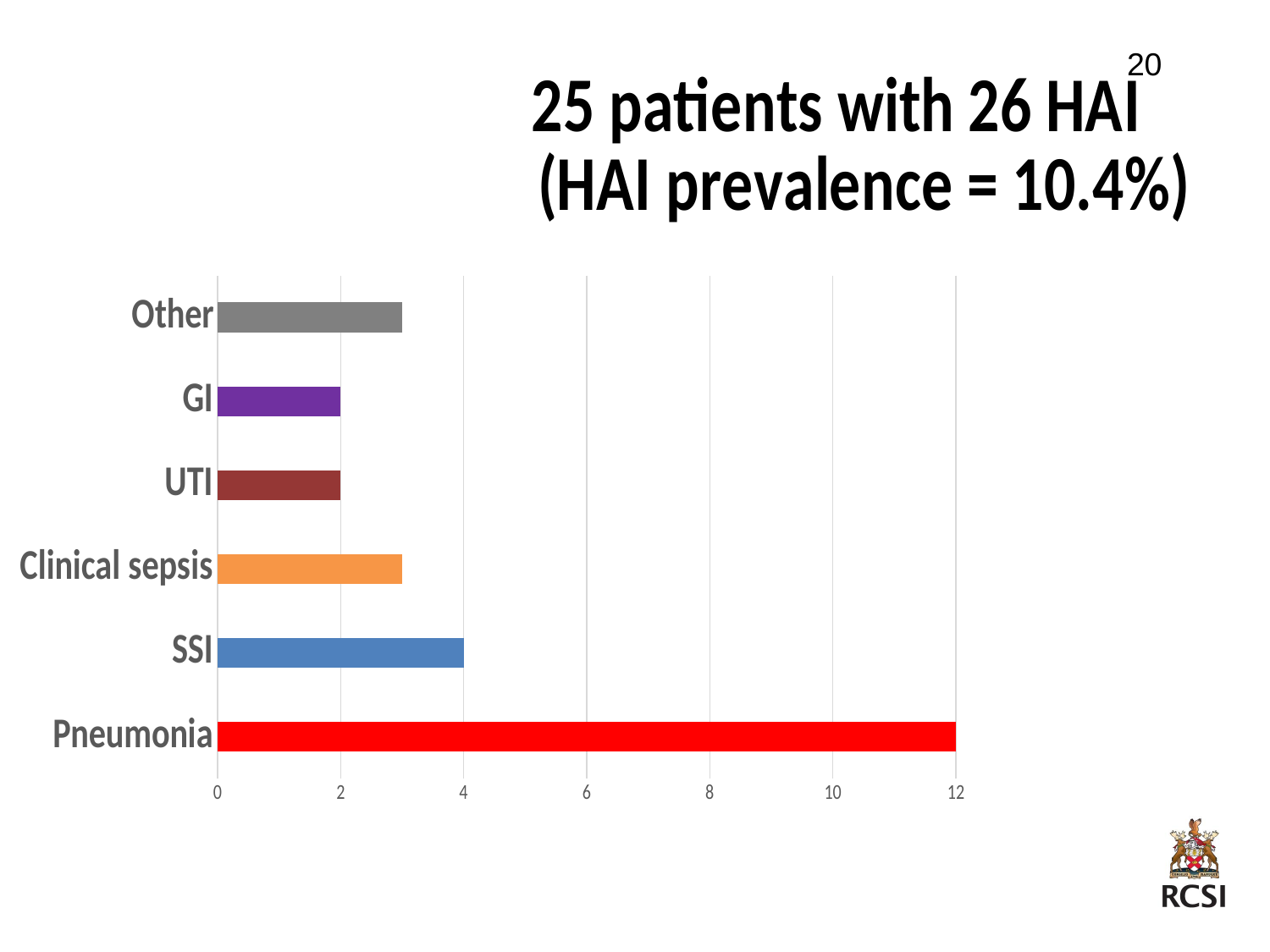
Is the value for Other greater or less than 2? greater Which category has the highest value in the chart? Pneumonia What is the value for UTI? 2 What is the value for SSI? 4 What type of chart is shown on the slide? bar chart What HAI prevalence is stated in the slide title? 10.4% What is the value for Pneumonia? 12 Which is larger, the value for SSI or the value for GI? SSI What is the difference between the values for Pneumonia and SSI? 8 How many categories are plotted in the chart? 6 What is the value for GI? 2 Is the value for Clinical sepsis greater or less than 4? less